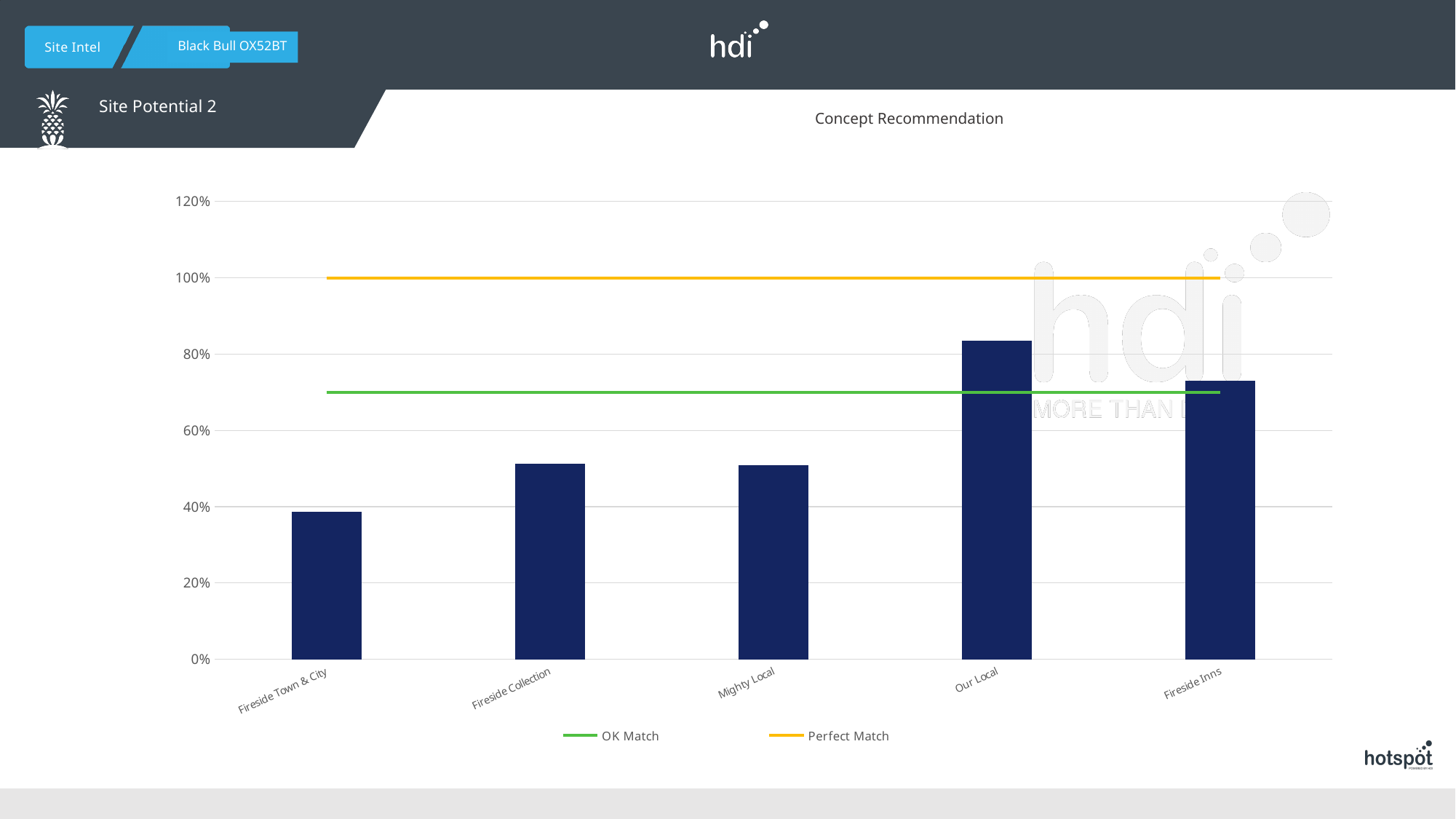
Which concept has the lowest bar? Fireside Town & City Which is larger, the bar for Our Local or the bar for Fireside Inns? Our Local Is the value for Fireside Inns greater or less than 60%? greater What kind of chart is shown on the slide? bar chart Is the value for Fireside Town & City greater or less than 40%? less How many series does the legend list? 2 At what level is the Perfect Match line drawn? 100% Is the value for Our Local greater or less than 80%? greater What is the title of the chart? Concept Recommendation How many concepts (categories) are plotted on the x axis? 5 Which concept has the highest bar? Our Local